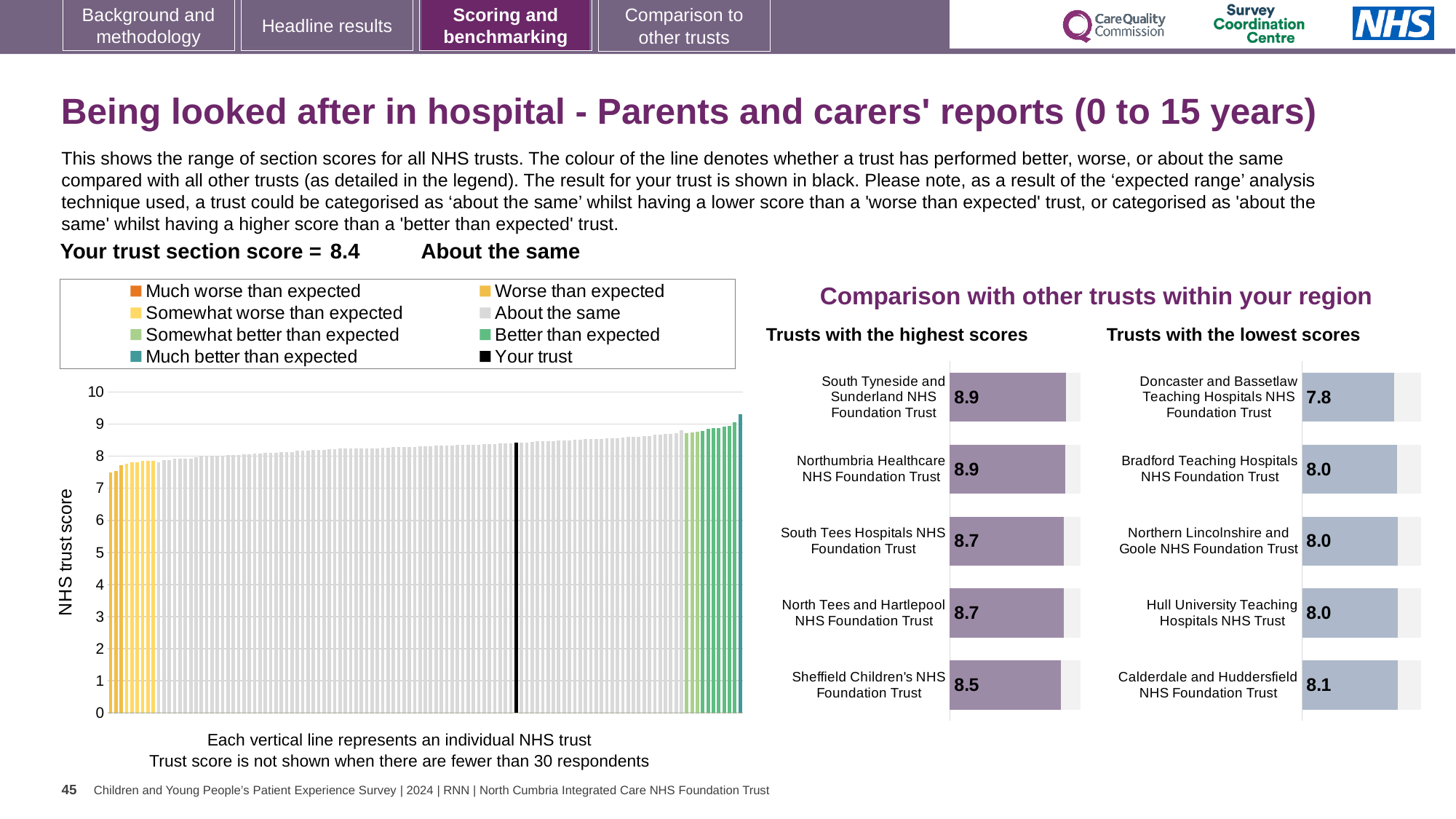
In the 'Trusts with the lowest scores' chart, what is the difference between the score for Calderdale and Huddersfield NHS Foundation Trust and the score for Doncaster and Bassetlaw Teaching Hospitals NHS Foundation Trust? 0.3 In the 'Trusts with the lowest scores' chart, which trust has the highest score shown? Calderdale and Huddersfield NHS Foundation Trust In the 'Trusts with the lowest scores' chart, what is the score for Doncaster and Bassetlaw Teaching Hospitals NHS Foundation Trust? 7.8 In the large chart on the left showing the range of section scores, do the trust scores rise or fall from left to right? Rise In the 'Trusts with the highest scores' chart, which trust has the lowest score shown? Sheffield Children's NHS Foundation Trust In the 'Trusts with the highest scores' chart, what is the difference between the score for South Tyneside and Sunderland NHS Foundation Trust and the score for Sheffield Children's NHS Foundation Trust? 0.4 How many entries does the legend of the large chart on the left list? 8 How many trusts are listed in the 'Trusts with the lowest scores' chart? 5 Which is larger: the score for North Tees and Hartlepool NHS Foundation Trust in the 'highest scores' chart or the score for Hull University Teaching Hospitals NHS Trust in the 'lowest scores' chart? North Tees and Hartlepool NHS Foundation Trust What kind of chart is the 'Trusts with the highest scores' chart? Bar chart In the 'Trusts with the highest scores' chart, what is the score for South Tees Hospitals NHS Foundation Trust? 8.7 In the large chart on the left, is the value for the black 'Your trust' line greater or less than 8? greater